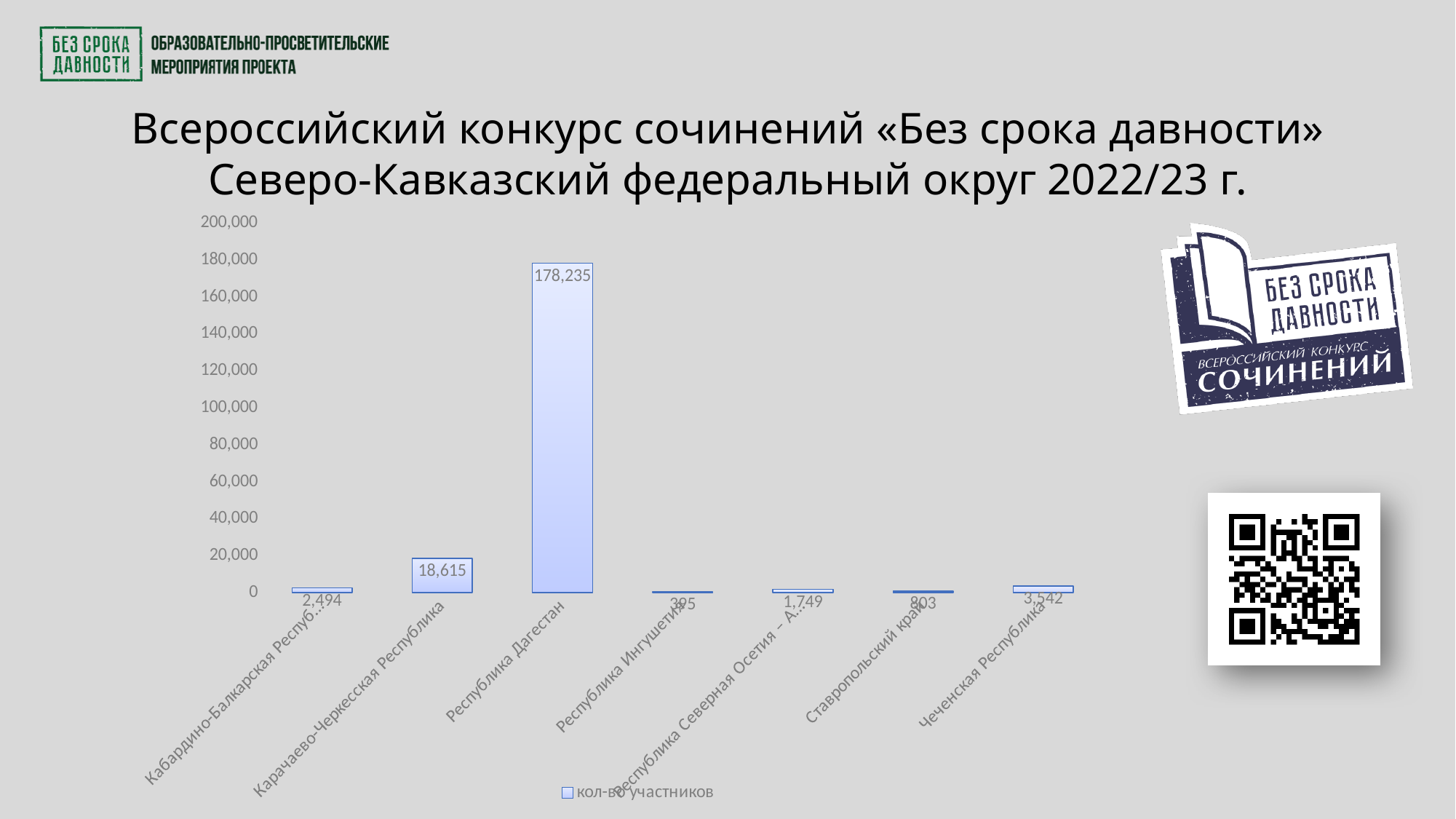
What is the value for Республика Северная Осетия – Алания? 1,749 What is the difference between the values for Республика Дагестан and Карачаево-Черкесская Республика? 159,620 What is the value for Кабардино-Балкарская Республика? 2,494 How many categories are shown on the x axis? 7 What is the value for Чеченская Республика? 3,542 How many series does the legend list? 1 Which is larger, the value for Чеченская Республика or the value for Кабардино-Балкарская Республика? Чеченская Республика What is the value for Карачаево-Черкесская Республика? 18,615 What is the value for Республика Дагестан? 178,235 What kind of chart is shown on the slide? bar chart What is the legend entry of the series shown in the chart? кол-во участников Which category has the highest value? Республика Дагестан